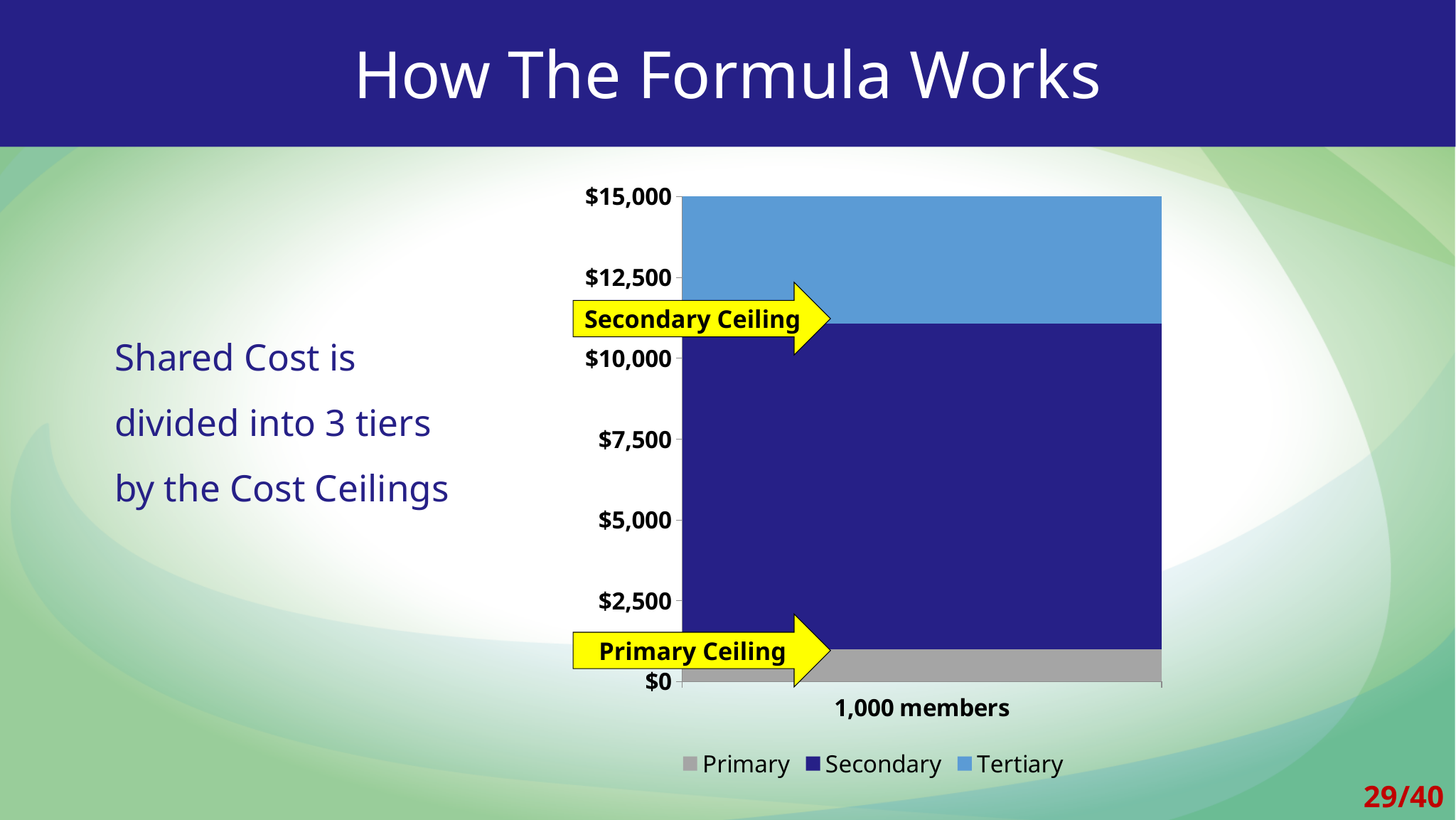
Which series forms the largest segment of the stacked bar? Secondary What is the label of the single category on the x axis? 1,000 members Is the Secondary Ceiling level on the chart greater or less than $10,000? greater Is the Secondary segment of the bar greater or less than $7,500? greater How many series does the chart legend list? 3 Which series is larger in the stacked bar, Tertiary or Primary? Tertiary What kind of chart is shown on the slide? Stacked bar chart Is the Tertiary segment of the bar greater or less than $5,000? less How many categories are plotted on the x axis of the chart? 1 What is the total height of the stacked bar for 1,000 members? $15,000 Which series forms the smallest segment of the stacked bar? Primary